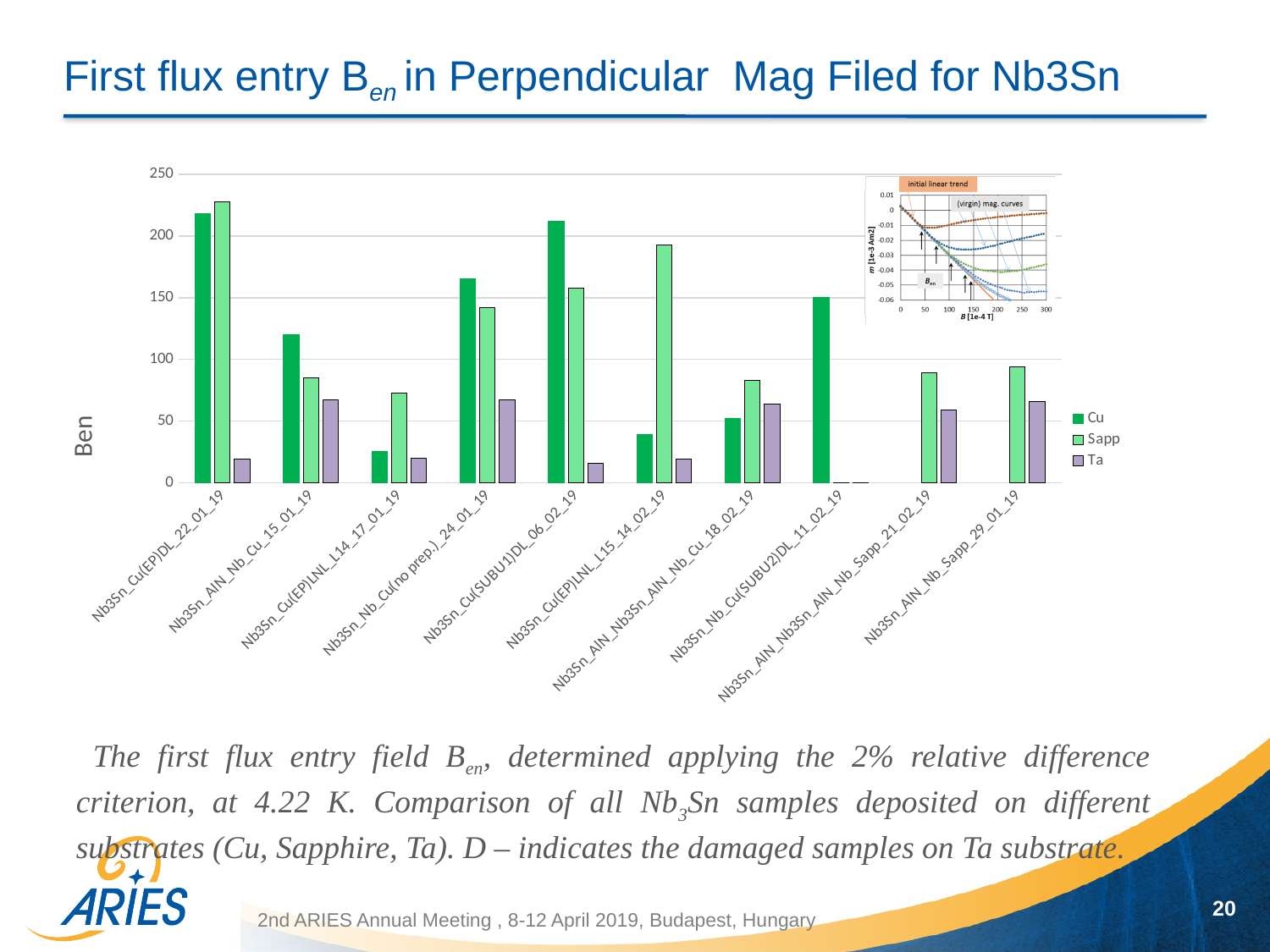
Is the Cu value for Nb3Sn_Cu(EP)DL_22_01_19 greater or less than 200? greater Which category has the highest Sapp value? Nb3Sn_Cu(EP)DL_22_01_19 For Nb3Sn_Cu(SUBU1)DL_06_02_19, which is larger, the Cu value or the Sapp value? Cu How many sample categories are shown along the x axis? 10 What kind of chart is shown on the slide? bar chart For Nb3Sn_Cu(EP)LNL_L15_14_02_19, which is larger, the Cu value or the Sapp value? Sapp What is the label on the vertical axis? Ben Is the Sapp value for Nb3Sn_Cu(EP)LNL_L15_14_02_19 greater or less than 150? greater What are the series names listed in the legend? Cu, Sapp, Ta Which category has the highest Cu value? Nb3Sn_Cu(EP)DL_22_01_19 Is the Ta value for Nb3Sn_Cu(SUBU1)DL_06_02_19 greater or less than 50? less How many series does the legend list? 3